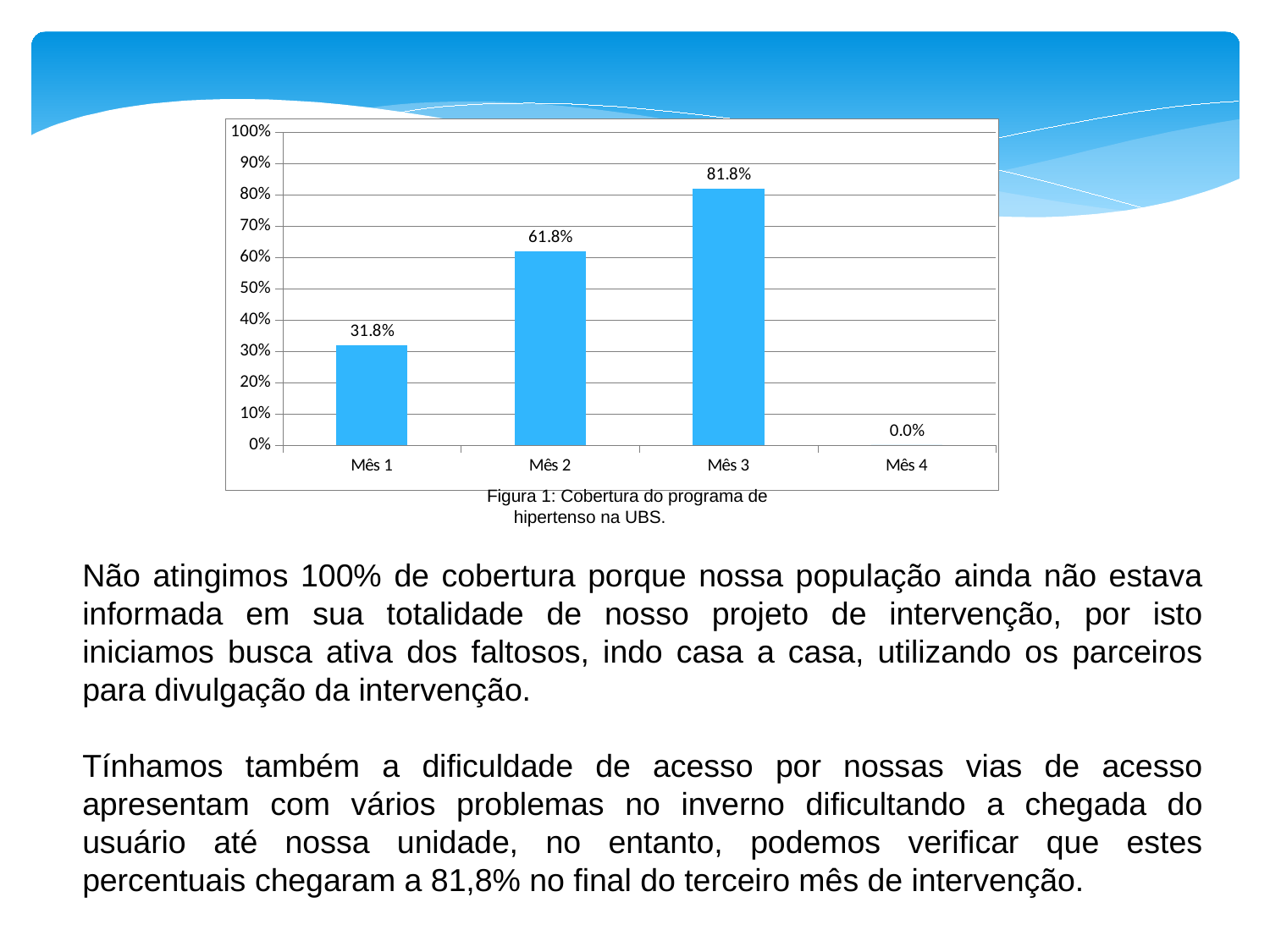
Which is larger, the value for Mês 2 or the value for Mês 3? Mês 3 What is the value for Mês 1? 31.8% Which month has the highest value? Mês 3 Which month has the lowest value? Mês 4 What is the value for Mês 2? 61.8% What is the difference between the values for Mês 3 and Mês 1? 50.0% What is the caption of the figure below the chart? Figura 1: Cobertura do programa de hipertenso na UBS. What is the value for Mês 3? 81.8% How many months are shown on the x axis? 4 What is the value for Mês 4? 0.0% What is the difference between the values for Mês 2 and Mês 1? 30.0% What kind of chart is shown on the slide? Bar chart